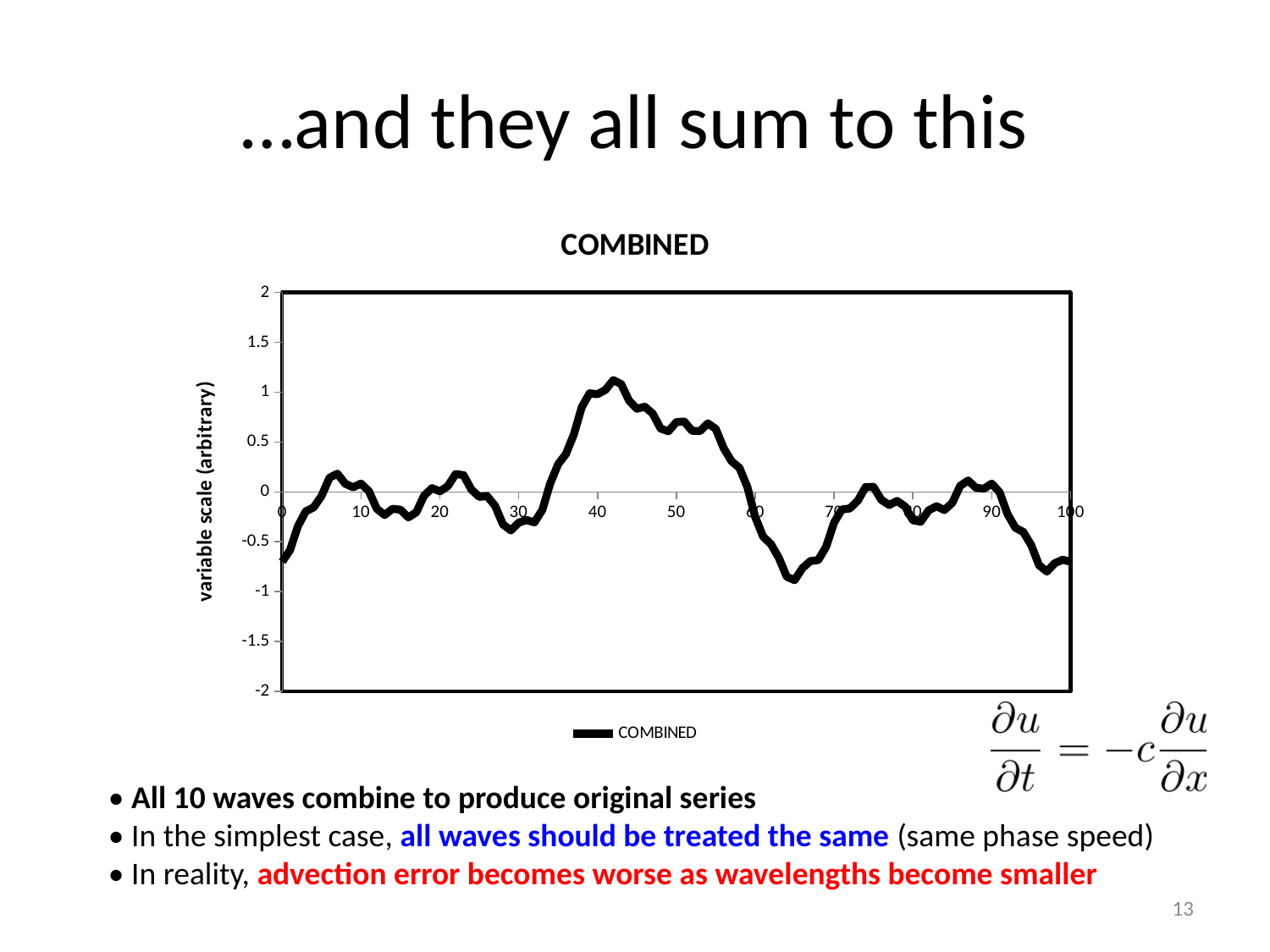
Does the COMBINED series rise or fall between x = 55 and x = 65? fall Does the COMBINED series rise or fall between x = 30 and x = 40? rise What is the title of the chart? COMBINED Is the value of the COMBINED series at x = 0 greater or less than 0? less Is the value of the COMBINED series at x = 50 greater or less than 0.5? greater Is the value of the COMBINED series at x = 30 greater or less than 0? less How many series does the chart's legend list? 1 What is the label of the vertical axis of the chart? variable scale (arbitrary) What kind of chart is shown on the slide? line chart Which is larger, the value of the COMBINED series at x = 40 or at x = 65? x = 40